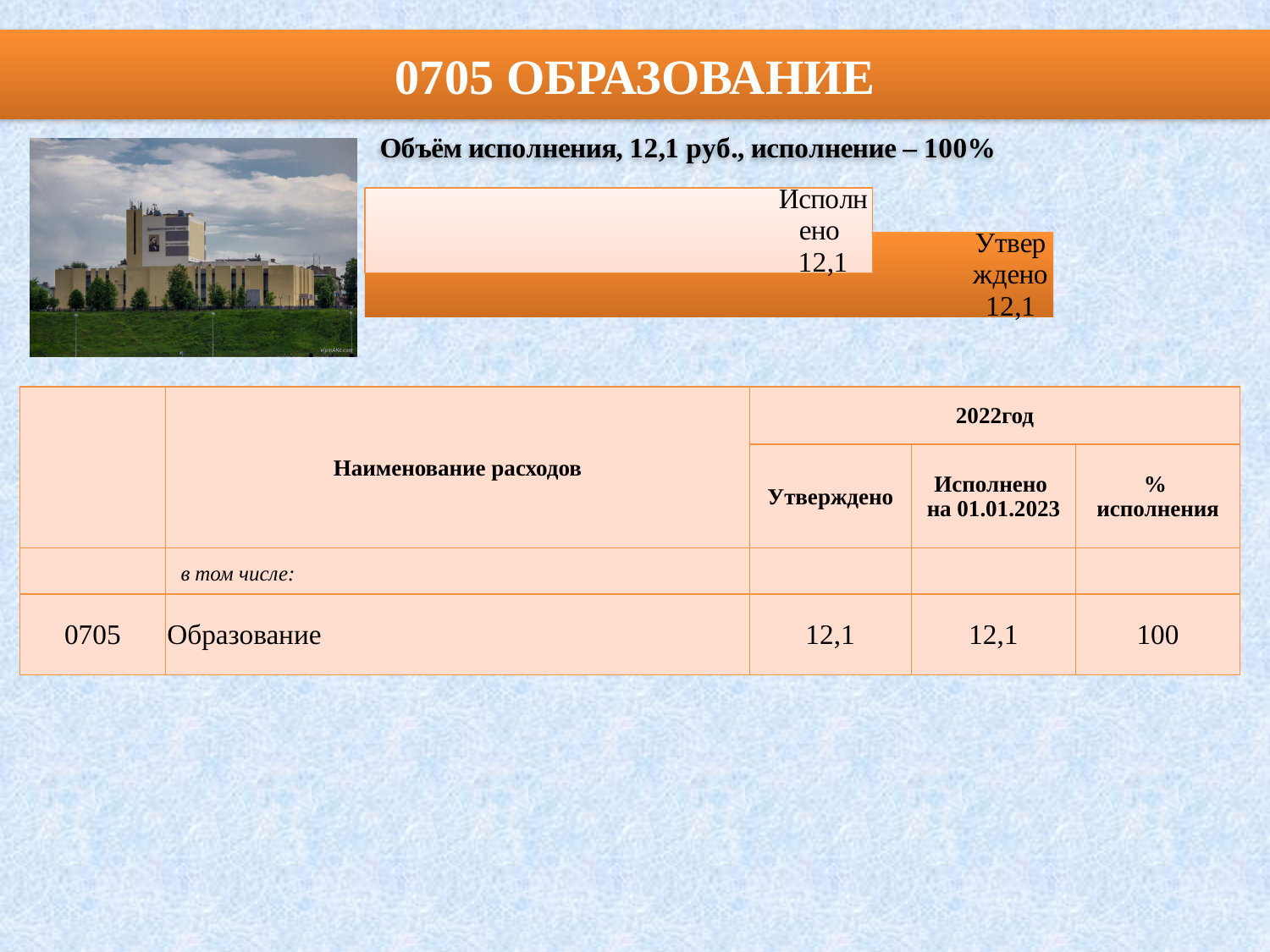
Are the bars in the chart horizontal or vertical? horizontal Is the value for "Исполнено" greater or less than 10? greater What is the difference between the "Утверждено" and "Исполнено" values in the chart? 0 Which bar in the chart is coloured dark orange? Утверждено What is the value of the bar labelled "Исполнено"? 12,1 Is the value for "Утверждено" greater or less than 20? less What kind of chart is shown on the slide? bar chart How many bars are plotted in the chart? 2 What is the value of the bar labelled "Утверждено"? 12,1